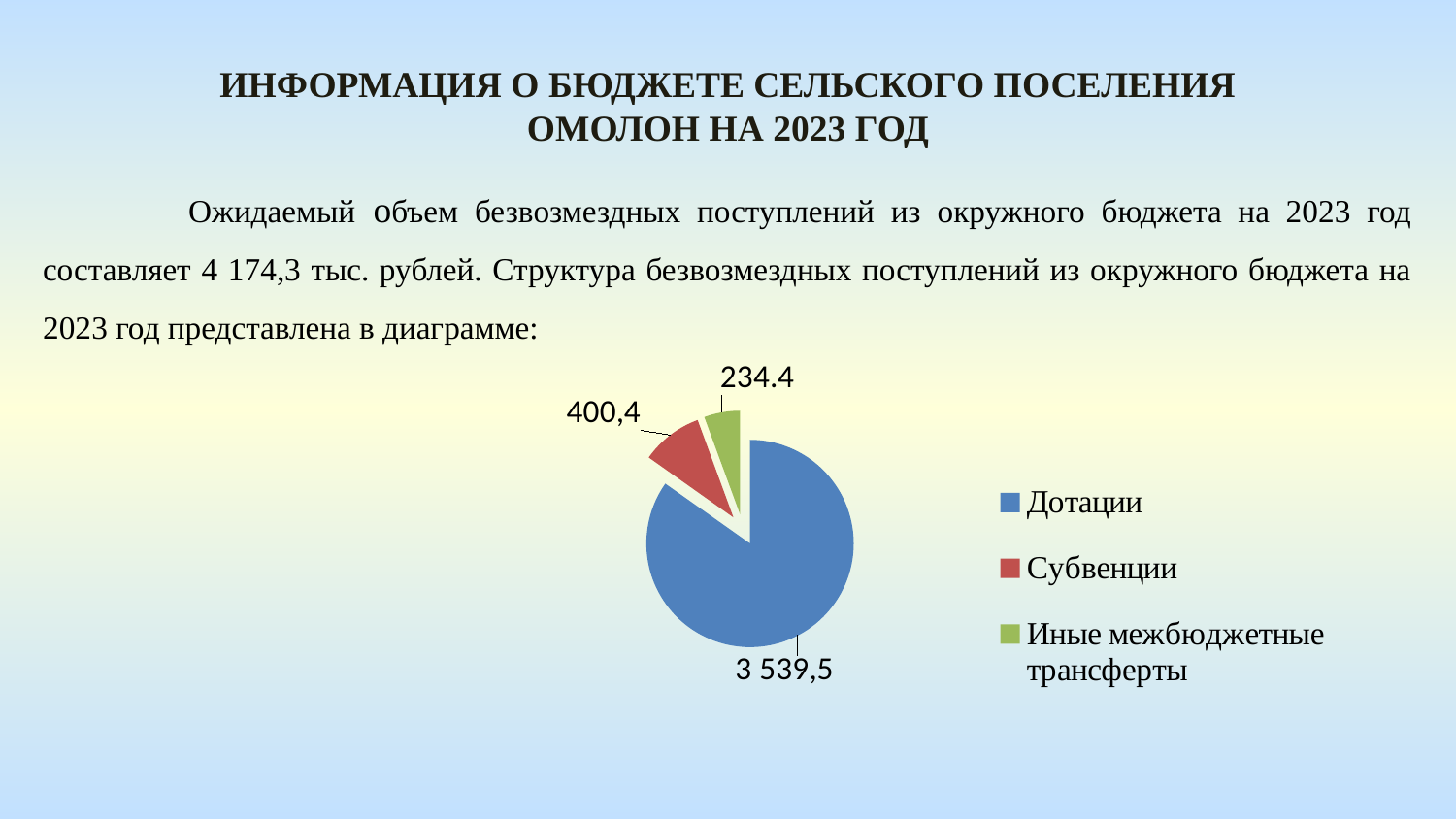
Which is larger, Субвенции or Иные межбюджетные трансферты? Субвенции What is the difference between the Субвенции and Иные межбюджетные трансферты values? 166 Which category has the largest slice of the pie? Дотации What type of chart is shown on the slide? pie chart What is the value of the Дотации slice? 3 539,5 What is the value of the Иные межбюджетные трансферты slice? 234.4 How many entries does the legend list? 3 Which category has the smallest slice of the pie? Иные межбюджетные трансферты What is the value of the Субвенции slice? 400,4 What colour is the Субвенции slice? red What is the difference between the Дотации and Субвенции values? 3 139,1 How many slices does the pie chart have? 3